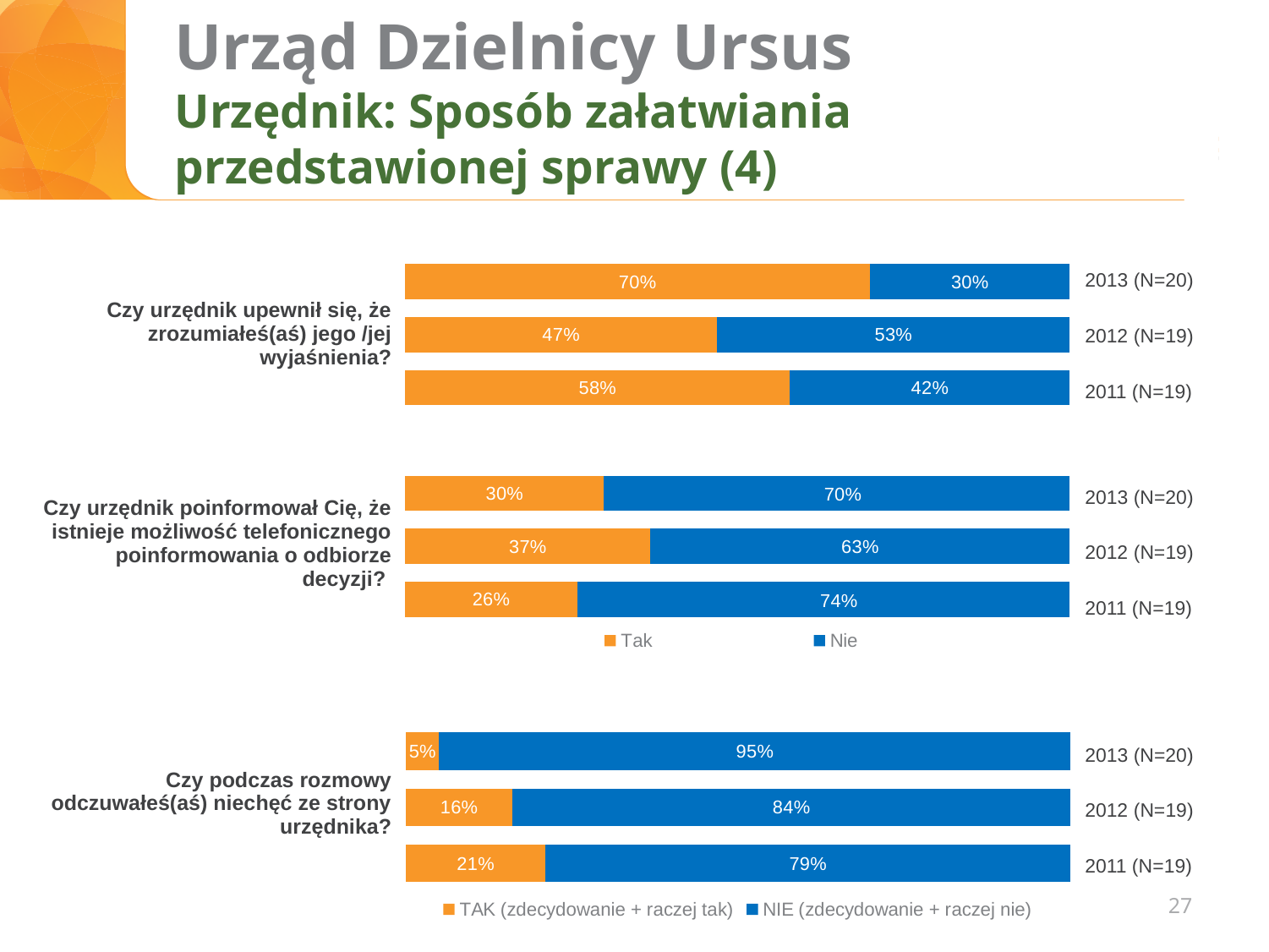
In the chart for "Czy urzędnik poinformował Cię, że istnieje możliwość telefonicznego poinformowania o odbiorze decyzji?", is the Tak value for 2012 larger or smaller than the Tak value for 2013? larger What kind of chart is used on this slide? Stacked bar chart In the chart for "Czy urzędnik upewnił się, że zrozumiałeś(aś) jego /jej wyjaśnienia?", what is the Nie value for 2012 (N=19)? 53% In the chart for "Czy urzędnik upewnił się, że zrozumiałeś(aś) jego /jej wyjaśnienia?", which year has the highest Tak value? 2013 (N=20) In the chart for "Czy urzędnik poinformował Cię, że istnieje możliwość telefonicznego poinformowania o odbiorze decyzji?", which year has the lowest Tak value? 2011 (N=19) In the chart for "Czy podczas rozmowy odczuwałeś(aś) niechęć ze strony urzędnika?", what is the TAK value for 2011 (N=19)? 21% In the chart for "Czy urzędnik upewnił się, że zrozumiałeś(aś) jego /jej wyjaśnienia?", what is the difference between the Tak values for 2013 and 2012? 23 percentage points In the chart for "Czy urzędnik upewnił się, że zrozumiałeś(aś) jego /jej wyjaśnienia?", what is the Tak value for 2013 (N=20)? 70% In the chart for "Czy podczas rozmowy odczuwałeś(aś) niechęć ze strony urzędnika?", what is the total of the 2012 (N=19) bar? 100% How many series does the legend of the bottom chart list? 2 In the chart for "Czy podczas rozmowy odczuwałeś(aś) niechęć ze strony urzędnika?", what is the NIE value for 2013 (N=20)? 95% In the chart for "Czy urzędnik poinformował Cię, że istnieje możliwość telefonicznego poinformowania o odbiorze decyzji?", what is the Nie value for 2011 (N=19)? 74%